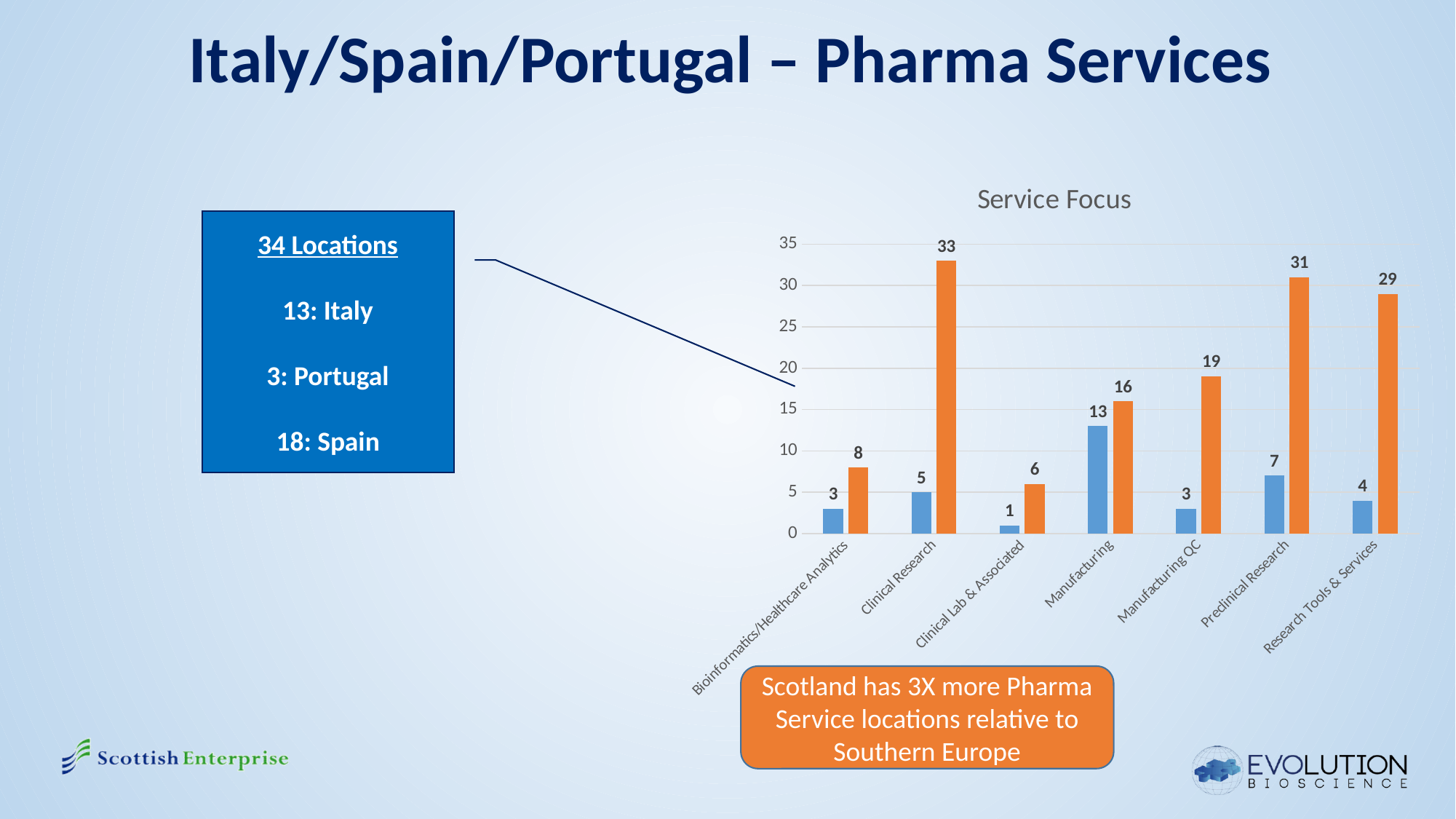
What is the value of the blue bar for Bioinformatics/Healthcare Analytics? 3 What is the title of the chart? Service Focus What is the difference between the orange and blue bars for Preclinical Research? 24 Which is larger for Manufacturing QC, the blue bar or the orange bar? the orange bar How many categories are shown on the x axis of the chart? 7 What is the value of the blue bar for Manufacturing? 13 What type of chart is shown on the slide? bar chart Which category has the lowest blue bar? Clinical Lab & Associated What is the value of the orange bar for Clinical Research? 33 Which category has the highest orange bar? Clinical Research Is the orange bar for Manufacturing greater or less than 15? greater What is the value of the orange bar for Research Tools & Services? 29